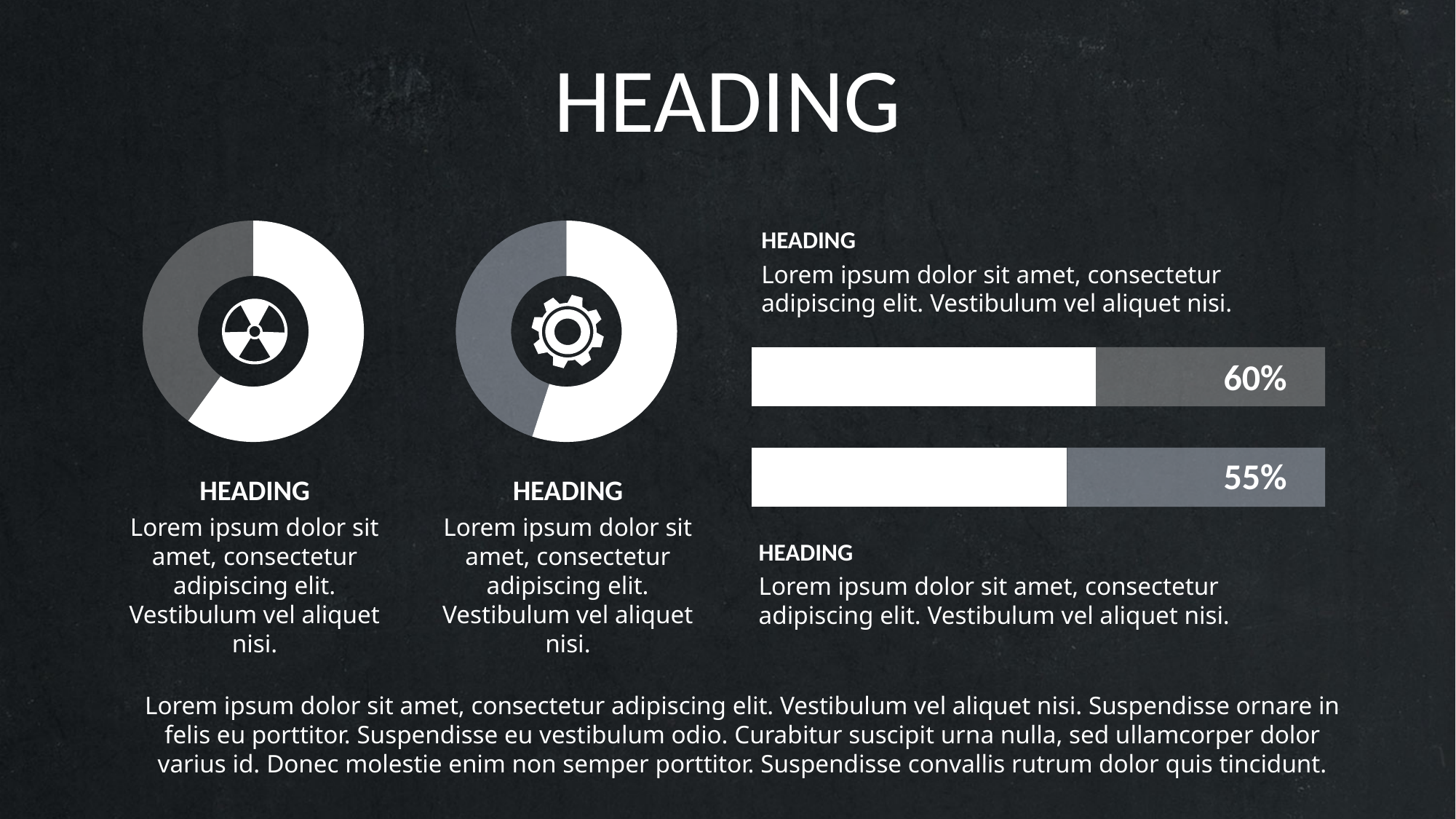
How many horizontal bars with percentage labels are on the right side of the slide? 2 What icon is shown in the centre of the middle donut chart? a gear In the left donut chart, which slice is larger, the white one or the grey one? white Which horizontal bar on the right has the lowest printed value? the bottom bar (55%) What kind of chart are the two circular graphics on the left side of the slide? donut chart What is the difference between the values printed on the top and bottom horizontal bars on the right? 5% In the middle donut chart, which slice is larger, the white one or the grey one? white What value is printed on the bottom horizontal bar on the right side of the slide? 55% Which of the two horizontal bars on the right shows the higher value, the top or the bottom one? top What icon is shown in the centre of the left donut chart? a radiation symbol How many donut (ring) charts are on the left side of the slide? 2 What value is printed on the top horizontal bar on the right side of the slide? 60%